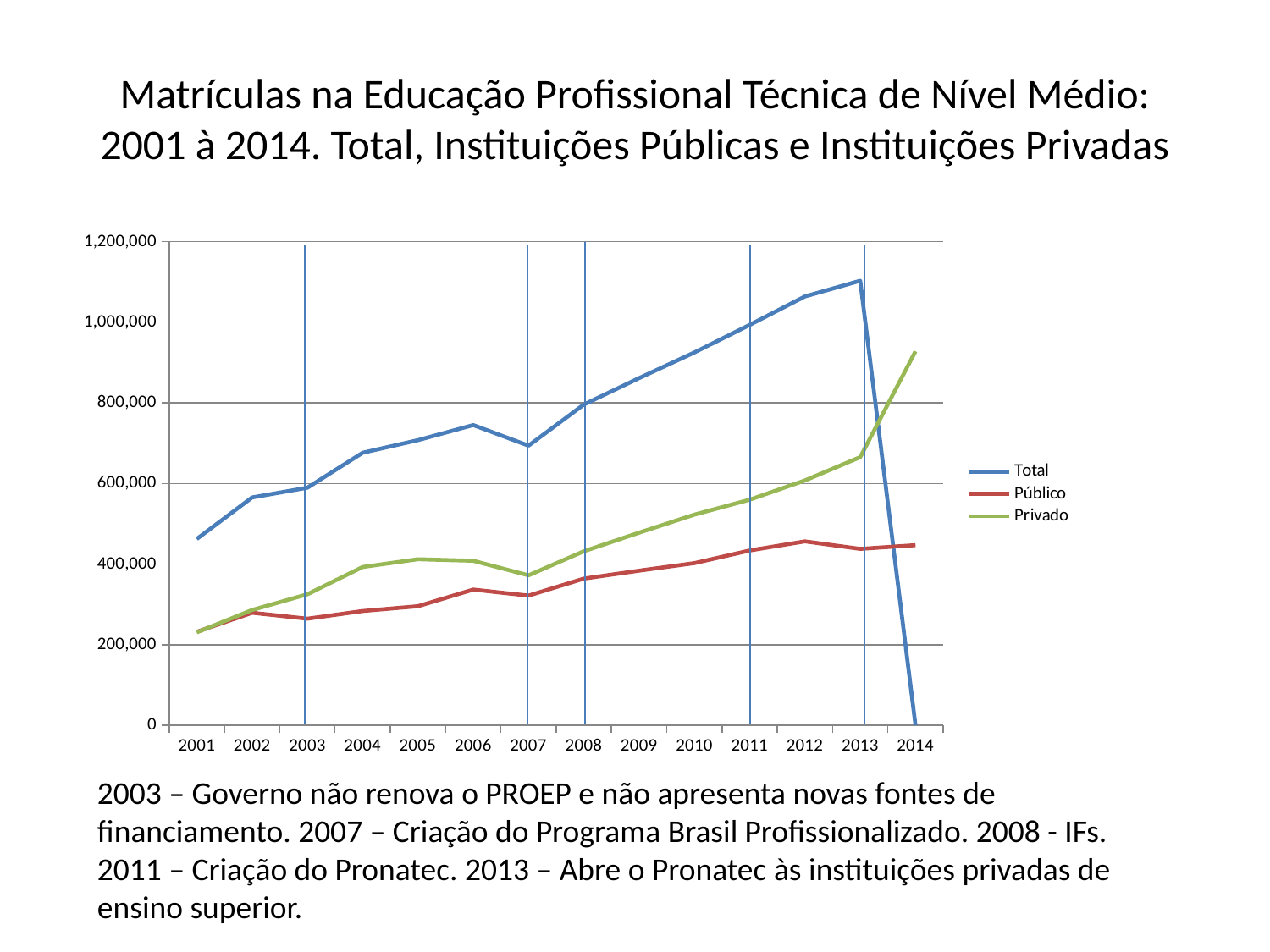
In which year does the Privado series reach its highest value? 2014 In 2014, which is larger, Privado or Público? Privado Does the Privado series rise or fall from 2008 to 2014? rise How many years are shown on the x axis? 14 Is the value for Público in 2001 greater or less than 400,000? less Is the value for Total in 2007 greater or less than 800,000? less What kind of chart is shown on the slide? line chart How many series does the legend list? 3 Which series does the legend list: name them in order. Total, Público, Privado In 2005, which is larger, Privado or Público? Privado Is the value for Total in 2013 greater or less than 1,000,000? greater